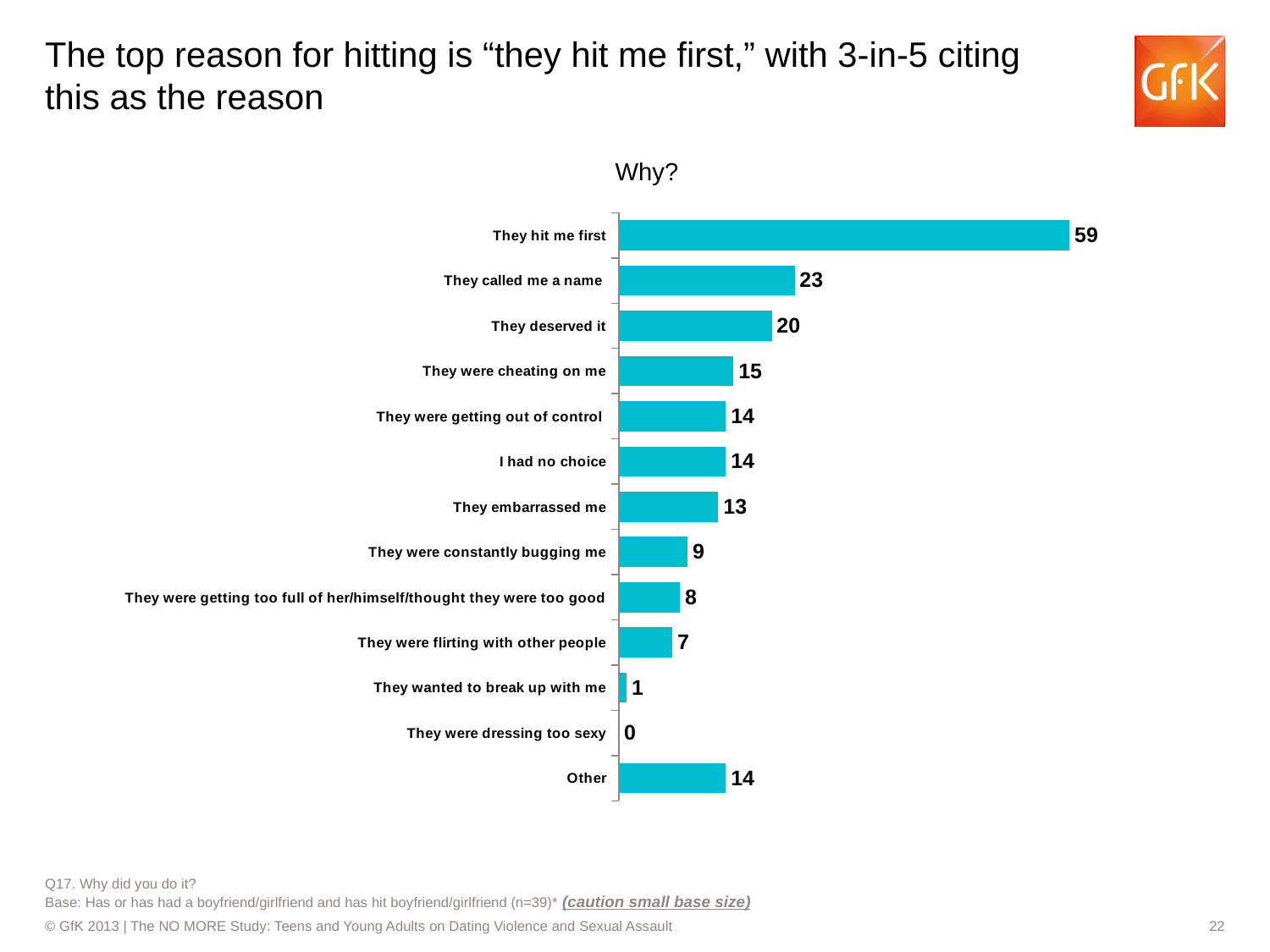
What is the difference between "They deserved it" and "They embarrassed me"? 7 Which reason has the lowest value? They were dressing too sexy What is the difference between "They hit me first" and "They called me a name"? 36 What is the value for "They hit me first"? 59 Which reason has the highest value? They hit me first What is the value for "They were cheating on me"? 15 Which is larger, "They were constantly bugging me" or "They were getting too full of her/himself/thought they were too good"? They were constantly bugging me What kind of chart is shown on the slide? Bar chart What is the value for "They were flirting with other people"? 7 How many categories are shown in the chart? 13 What is the value for "Other"? 14 What is the title of the chart? Why?